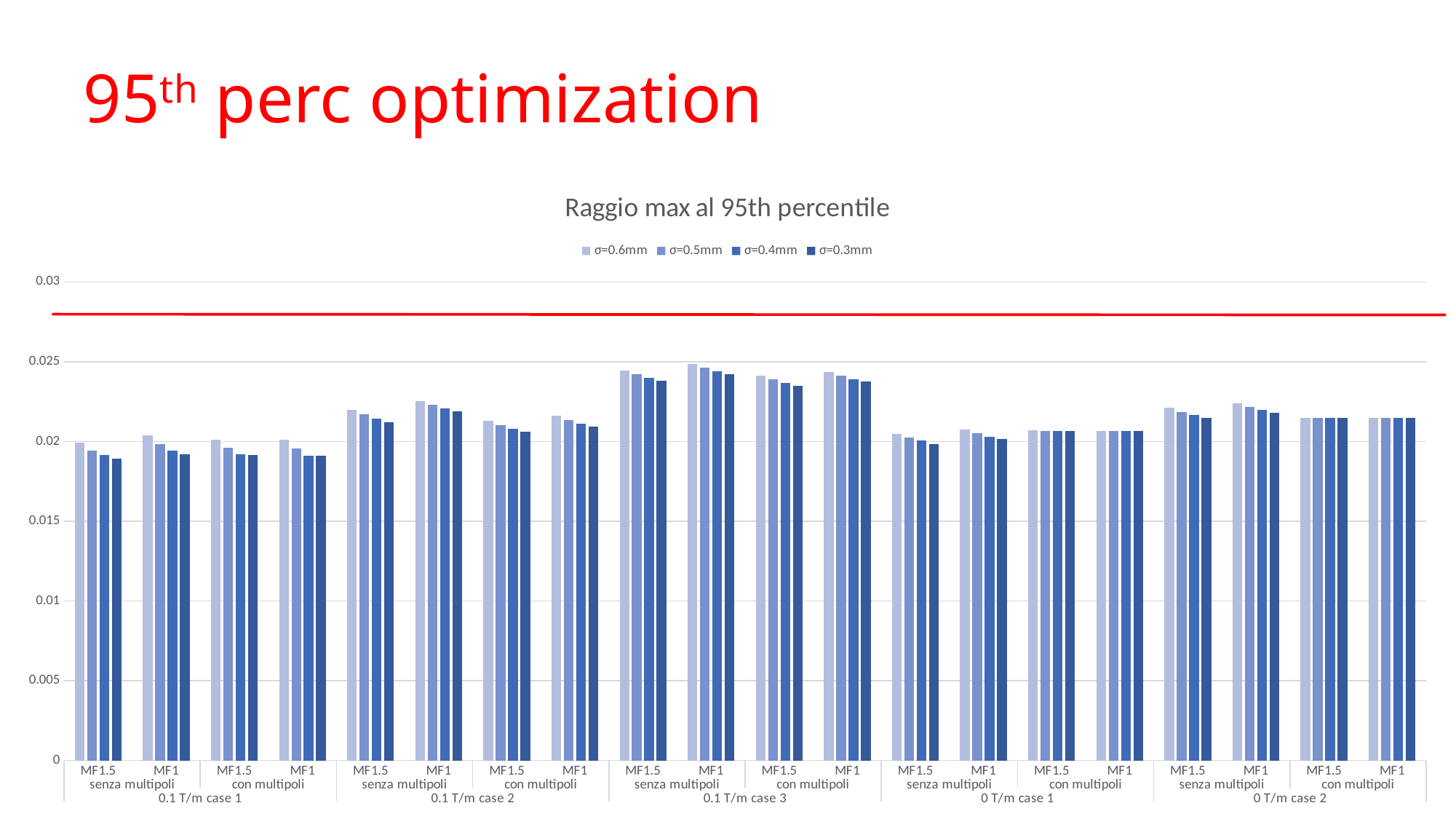
Which series is listed first in the legend? σ=0.6mm Is the value for σ=0.6mm at MF1, senza multipoli, 0.1 T/m case 3 greater or less than 0.02? greater Is the value for σ=0.4mm at MF1.5, con multipoli, 0 T/m case 2 greater or less than 0.015? greater Which top-level case group has the tallest bars overall? 0.1 T/m case 3 What kind of chart is shown on the slide? bar chart How many top-level case groups are shown along the x axis? 5 How many series does the legend list? 4 Which is larger: the σ=0.6mm value at MF1.5, senza multipoli, 0.1 T/m case 3 or the σ=0.6mm value at MF1.5, senza multipoli, 0.1 T/m case 1? 0.1 T/m case 3 Within the 0.1 T/m case 1 group at MF1.5 senza multipoli, do the bars rise or fall from σ=0.6mm to σ=0.3mm? fall Is the value for σ=0.3mm at MF1.5, senza multipoli, 0.1 T/m case 1 greater or less than 0.02? less What is the title of the chart? Raggio max al 95th percentile